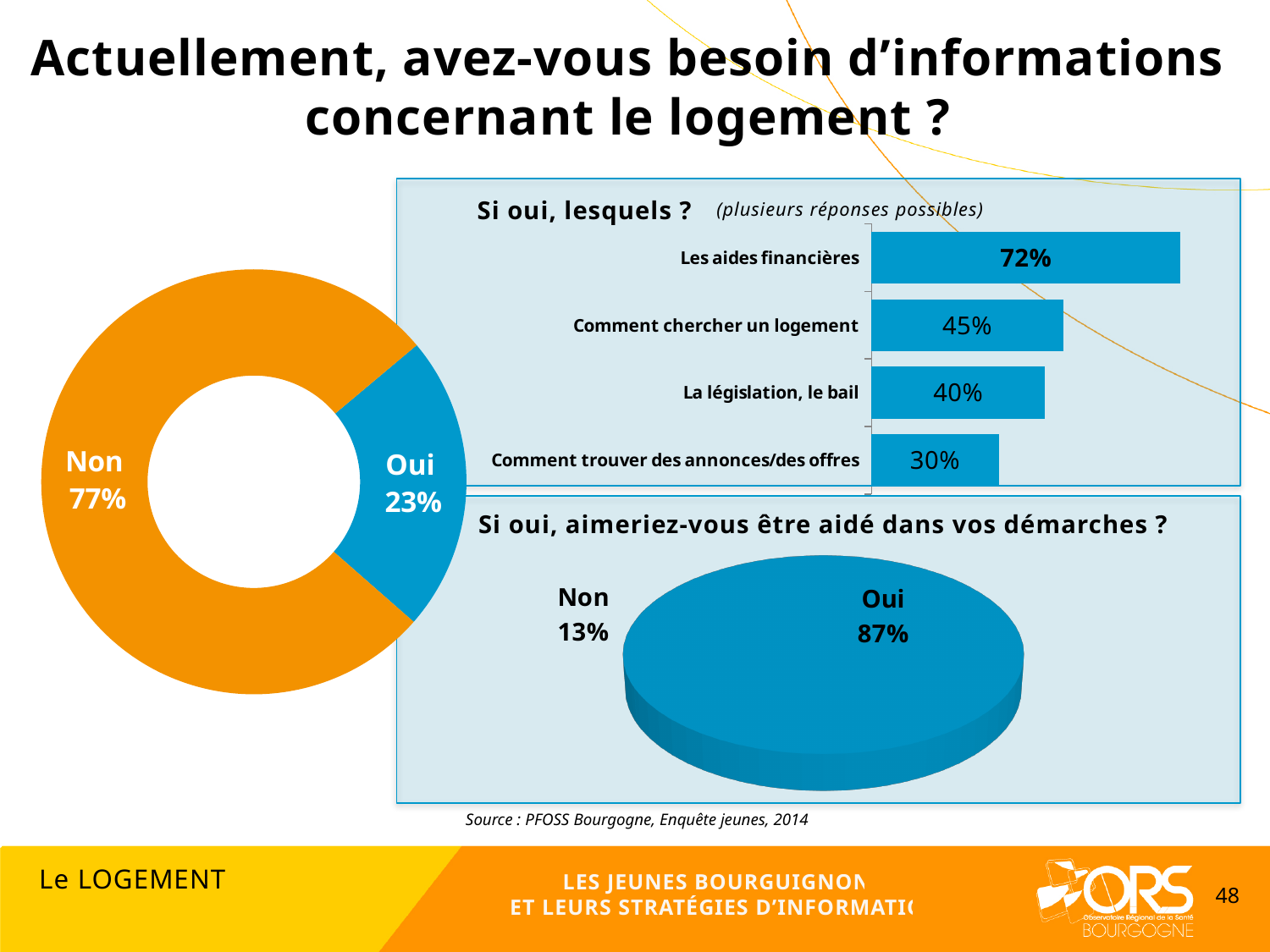
In the bar chart "Si oui, lesquels ?", which category has the lowest value? Comment trouver des annonces/des offres In the bar chart "Si oui, lesquels ?", what is the difference between "Les aides financières" and "Comment trouver des annonces/des offres"? 42% What kind of chart is used for "Si oui, lesquels ?"? Bar chart In the doughnut chart on the left, what percentage answered "Oui"? 23% In the bar chart "Si oui, lesquels ?", which category has the highest value? Les aides financières How many categories are shown in the bar chart "Si oui, lesquels ?"? 4 In the bar chart "Si oui, lesquels ?", what is the value for "Comment chercher un logement"? 45% In the doughnut chart on the left, which answer has the larger share, Oui or Non? Non In the doughnut chart on the left, what percentage answered "Non"? 77% In the pie chart "Si oui, aimeriez-vous être aidé dans vos démarches ?", what share answered "Oui"? 87% In the bar chart "Si oui, lesquels ?", what is the value for "Les aides financières"? 72% In the bar chart "Si oui, lesquels ?", what is the value for "La législation, le bail"? 40%